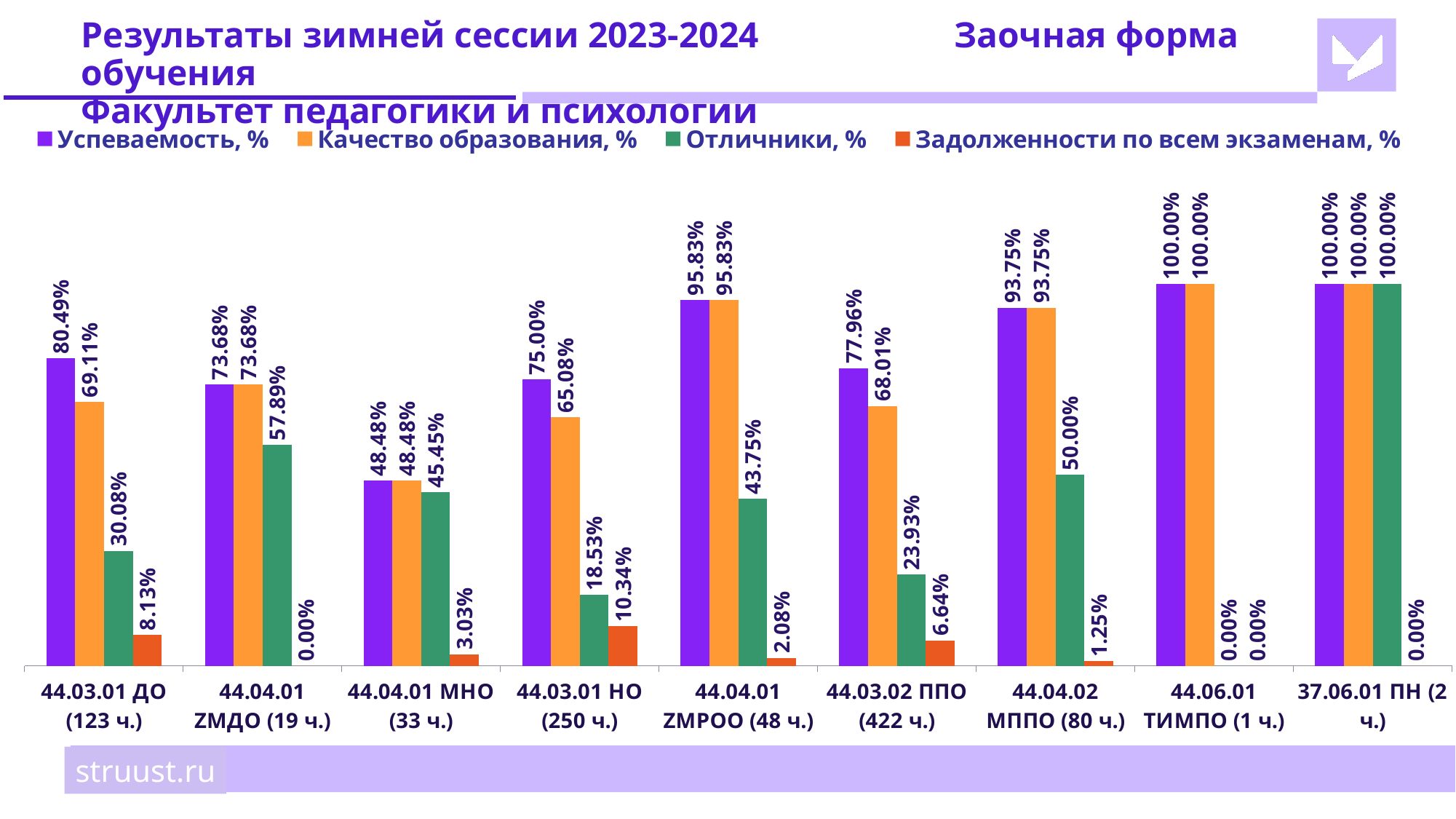
Which category has the lowest value of Успеваемость, %? 44.04.01 МНО (33 ч.) What is the difference between Успеваемость, % and Качество образования, % for 44.03.01 ДО (123 ч.)? 11.38% What is the value of Задолженности по всем экзаменам, % for 44.03.01 НО (250 ч.)? 10.34% What is the value of Успеваемость, % for 44.03.01 ДО (123 ч.)? 80.49% What is the value of Отличники, % for 44.04.02 МППО (80 ч.)? 50.00% Which category has the highest value of Задолженности по всем экзаменам, %? 44.03.01 НО (250 ч.) What is the value of Качество образования, % for 44.03.02 ППО (422 ч.)? 68.01% Which has a higher value of Отличники, %: 44.04.01 ZМДО (19 ч.) or 44.04.02 МППО (80 ч.)? 44.04.01 ZМДО (19 ч.) How many categories are shown on the x axis of the chart? 9 What kind of chart is shown on the slide? Bar chart What colour represents the series Отличники, % in the legend? Green How many series does the legend list? 4